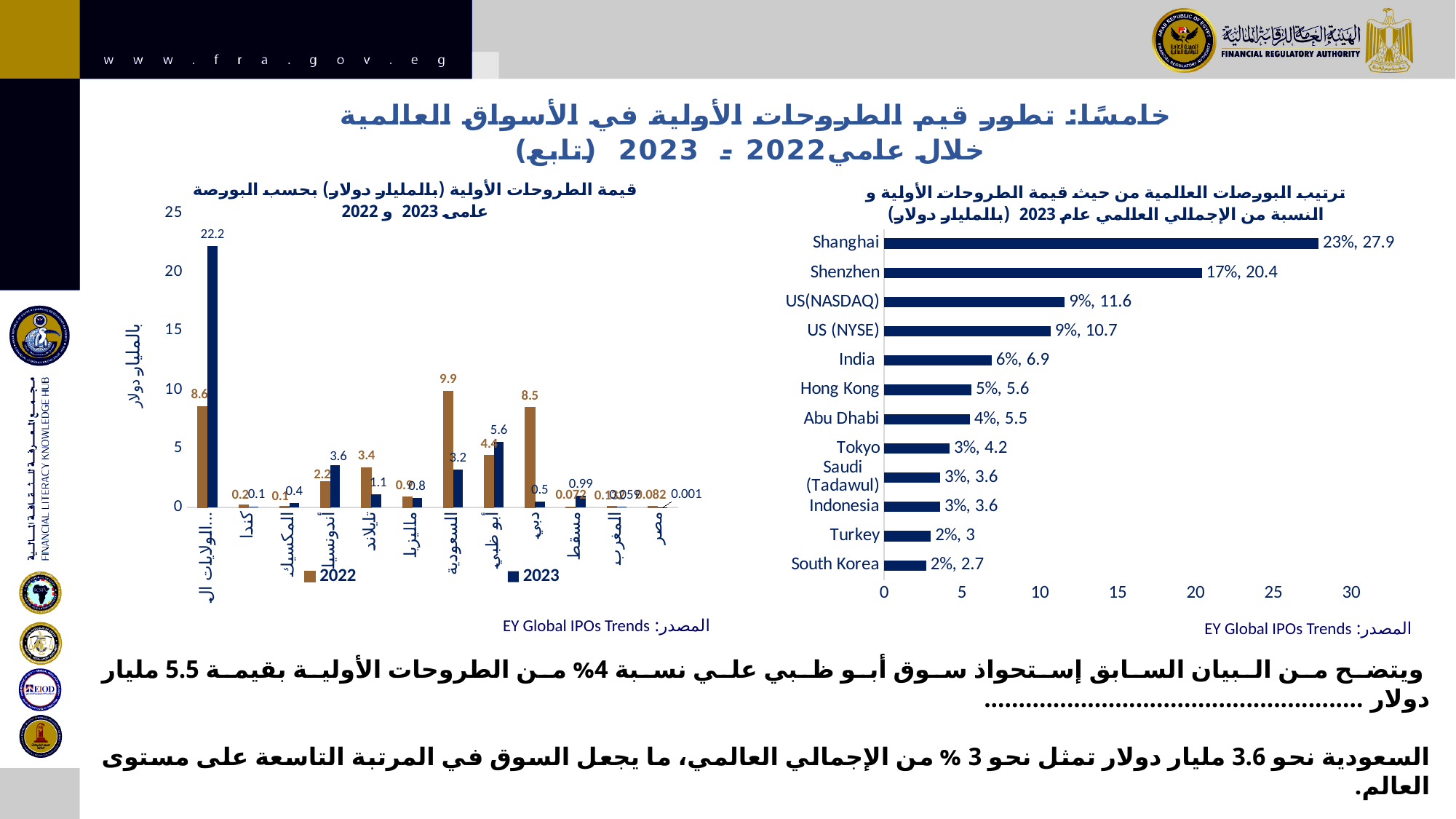
In the right chart ranking global exchanges by IPO value in 2023, which has the larger value, India or Hong Kong? India In the right chart ranking global exchanges by IPO value in 2023, is the value for US(NASDAQ) greater or less than 10? greater In the left chart of IPO values by exchange for 2022 and 2023, how many series does the legend list? 2 In the left chart of IPO values by exchange for 2022 and 2023, what is the 2022 value for Saudi Arabia (السعودية)? 9.9 In the right chart ranking global exchanges by IPO value in 2023, what is the IPO value (in billion dollars) for Shanghai? 27.9 In the right chart ranking global exchanges by IPO value in 2023, what percentage of the global total does Shenzhen account for? 17% In the right chart ranking global exchanges by IPO value in 2023, what is the difference between the values for Shanghai and Shenzhen? 7.5 In the left chart of IPO values by exchange for 2022 and 2023, what is the 2023 value for the United States (الولايات المتحدة)? 22.2 In the right chart ranking global exchanges by IPO value in 2023, how many exchanges are listed? 12 What kind of chart is the right chart ranking global exchanges by IPO value in 2023? bar chart In the right chart ranking global exchanges by IPO value in 2023, which exchange has the highest value? Shanghai In the right chart ranking global exchanges by IPO value in 2023, which exchange has the lowest value? South Korea